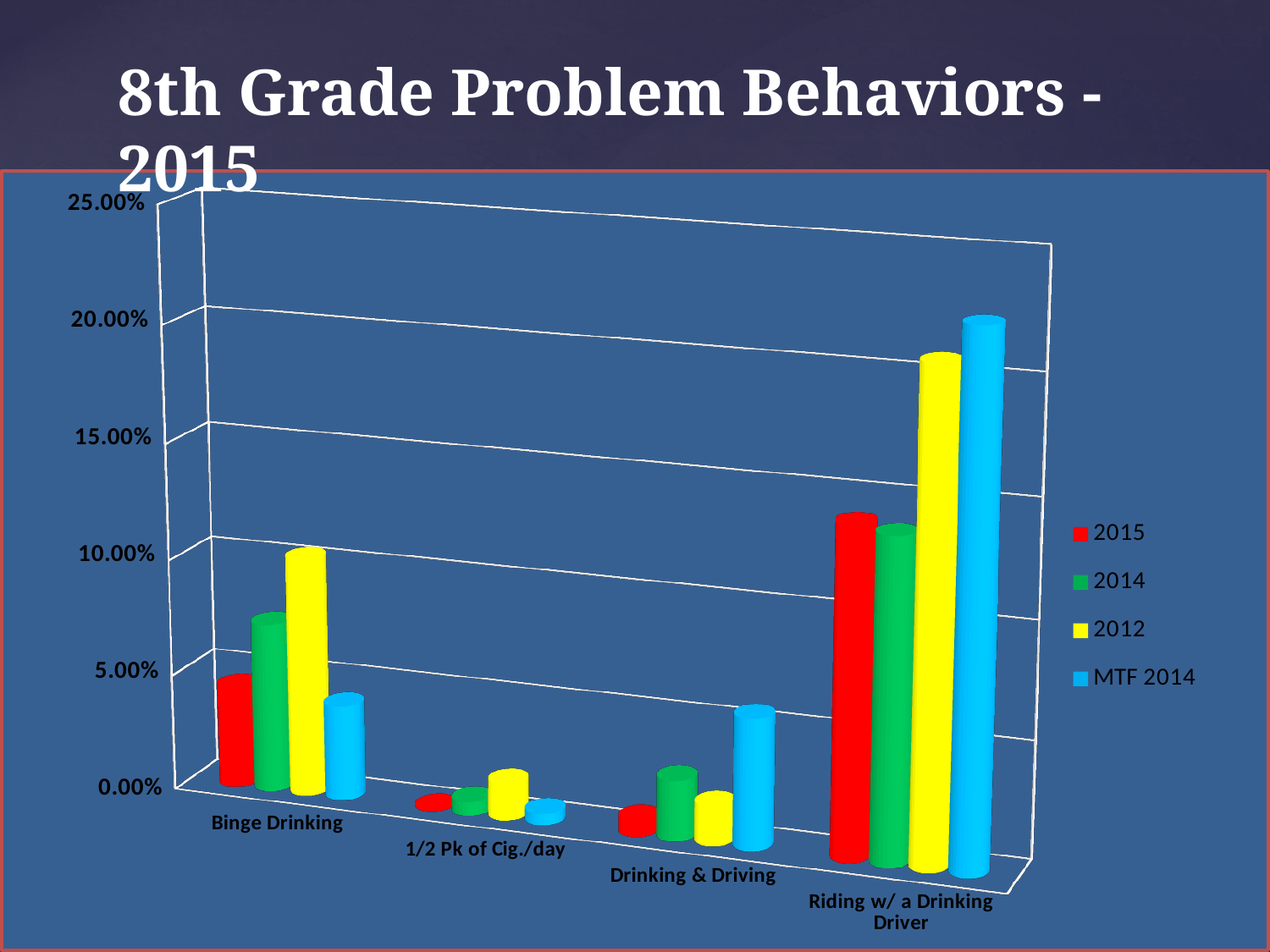
Is the 2015 value for Riding w/ a Drinking Driver greater or less than 10.00%? greater How many behavior categories are shown on the x axis? 4 For Binge Drinking, is the 2012 value larger or the 2015 value? 2012 For Binge Drinking, which series has the highest value? 2012 What is the title of the chart on the slide? 8th Grade Problem Behaviors - 2015 Which category has the lowest values across all series? 1/2 Pk of Cig./day How many series does the legend list? 4 For Riding w/ a Drinking Driver, which series has the highest value? MTF 2014 Is the 2012 value for Riding w/ a Drinking Driver greater or less than 15.00%? greater What kind of chart is shown on the slide? bar chart Which category has the highest values across all series? Riding w/ a Drinking Driver